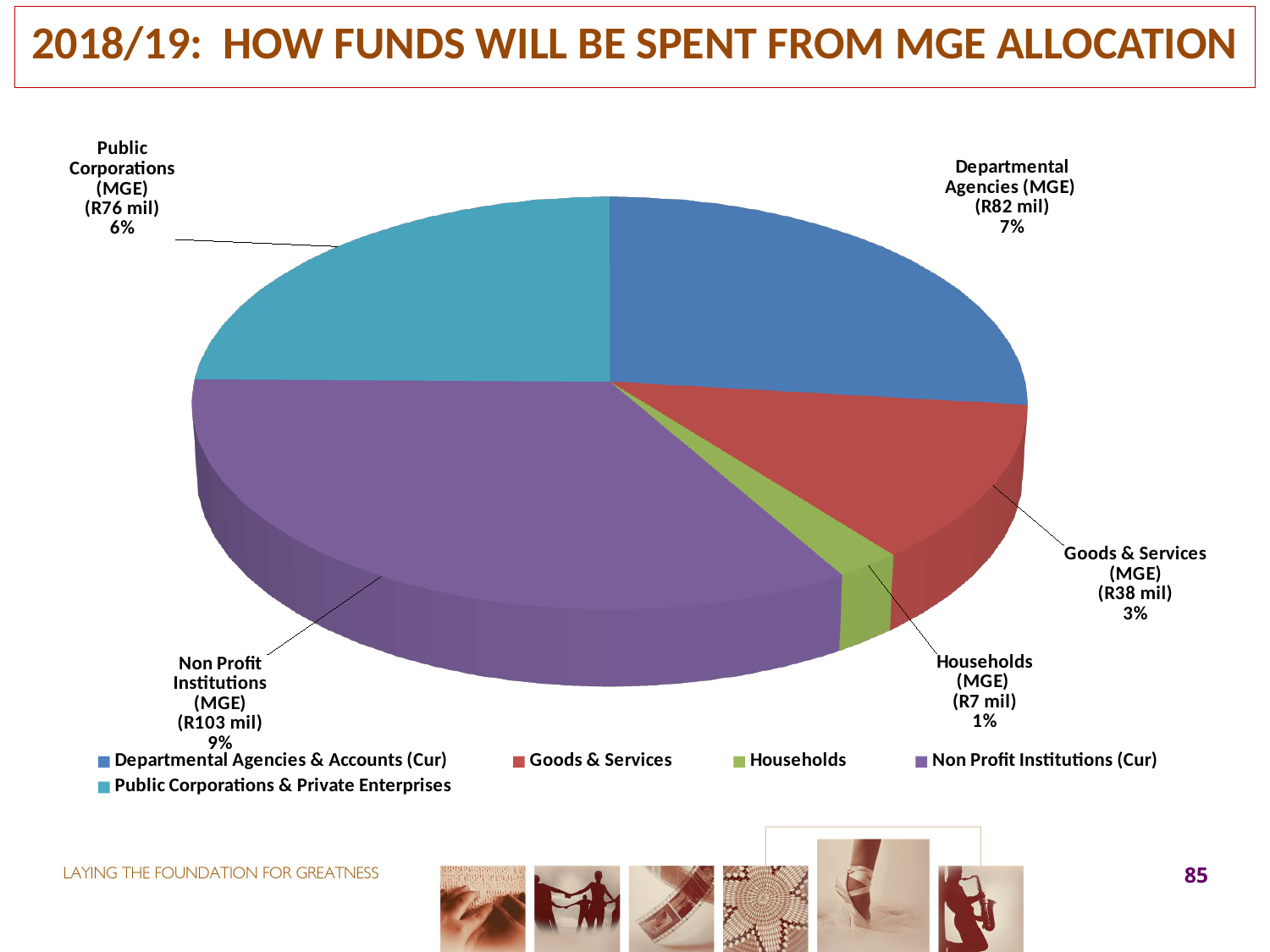
What is the title of the chart on the slide? 2018/19: How funds will be spent from MGE allocation Which category has the smallest amount? Households (MGE) Which has a larger amount, Goods & Services (MGE) or Public Corporations (MGE)? Public Corporations (MGE) What percentage is shown for Departmental Agencies (MGE)? 7% What kind of chart is shown on the slide? Pie chart What amount is shown for Goods & Services (MGE)? R38 mil How many entries does the legend list? 5 What percentage is shown for Households (MGE)? 1% What amount is shown for Non Profit Institutions (MGE)? R103 mil Which category has the largest amount? Non Profit Institutions (MGE) What is the difference in amount between Departmental Agencies (MGE) and Public Corporations (MGE)? R6 mil How many slices does the pie chart have? 5